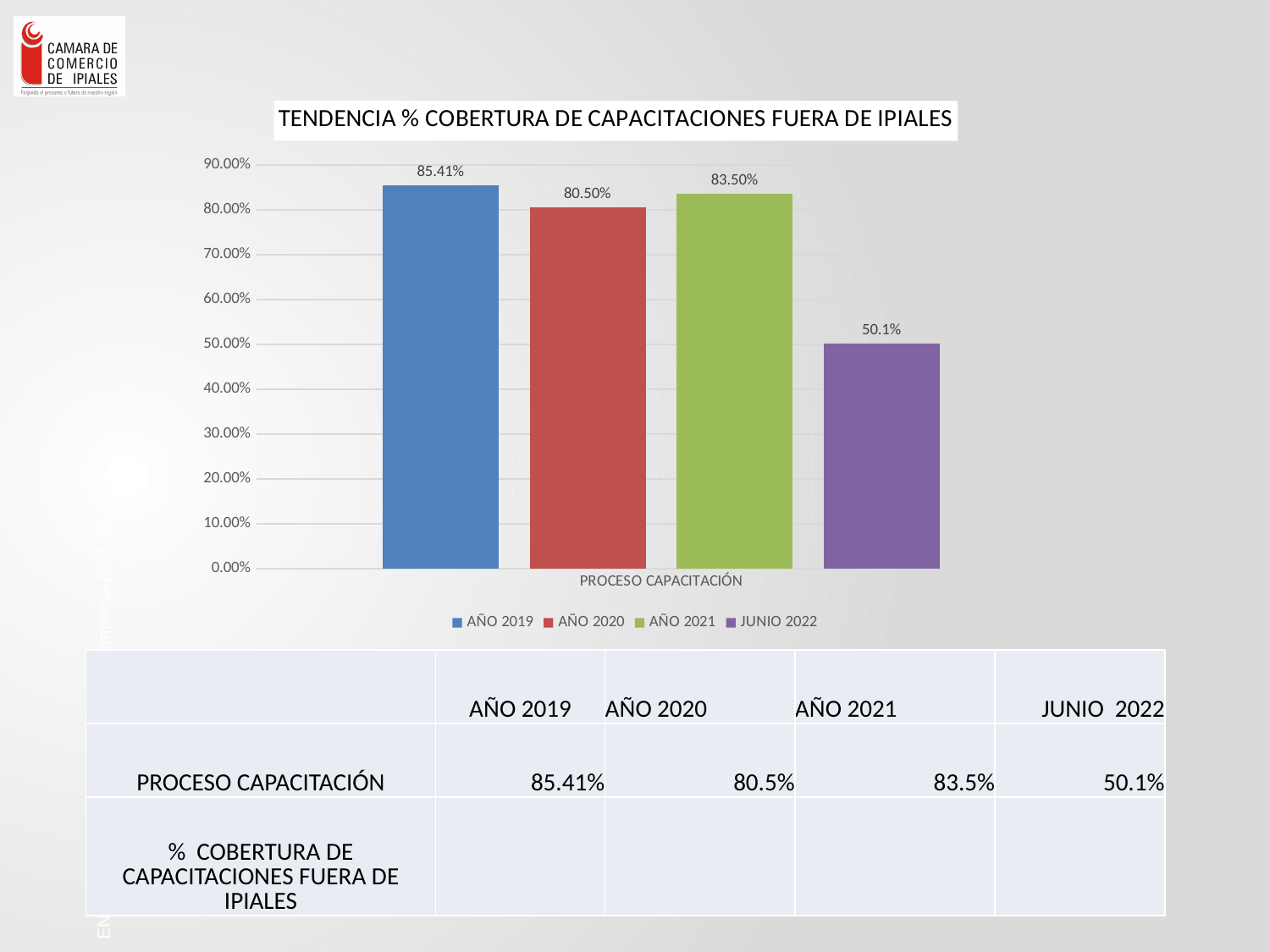
What is the value for AÑO 2021 in the chart? 83.50% Which series has the highest value in the chart? AÑO 2019 Is the value for JUNIO 2022 greater or less than 60.00%? less What is the title of the chart? TENDENCIA % COBERTURA DE CAPACITACIONES FUERA DE IPIALES What is the value for AÑO 2020 in the chart? 80.50% Which is larger, the value for AÑO 2020 or the value for AÑO 2021? AÑO 2021 How many series does the legend list? 4 What is the value for AÑO 2019 in the chart? 85.41% What is the value for JUNIO 2022 in the chart? 50.1% What is the difference between the AÑO 2019 value and the JUNIO 2022 value? 35.31% What kind of chart is shown on the slide? bar chart Which series has the lowest value in the chart? JUNIO 2022